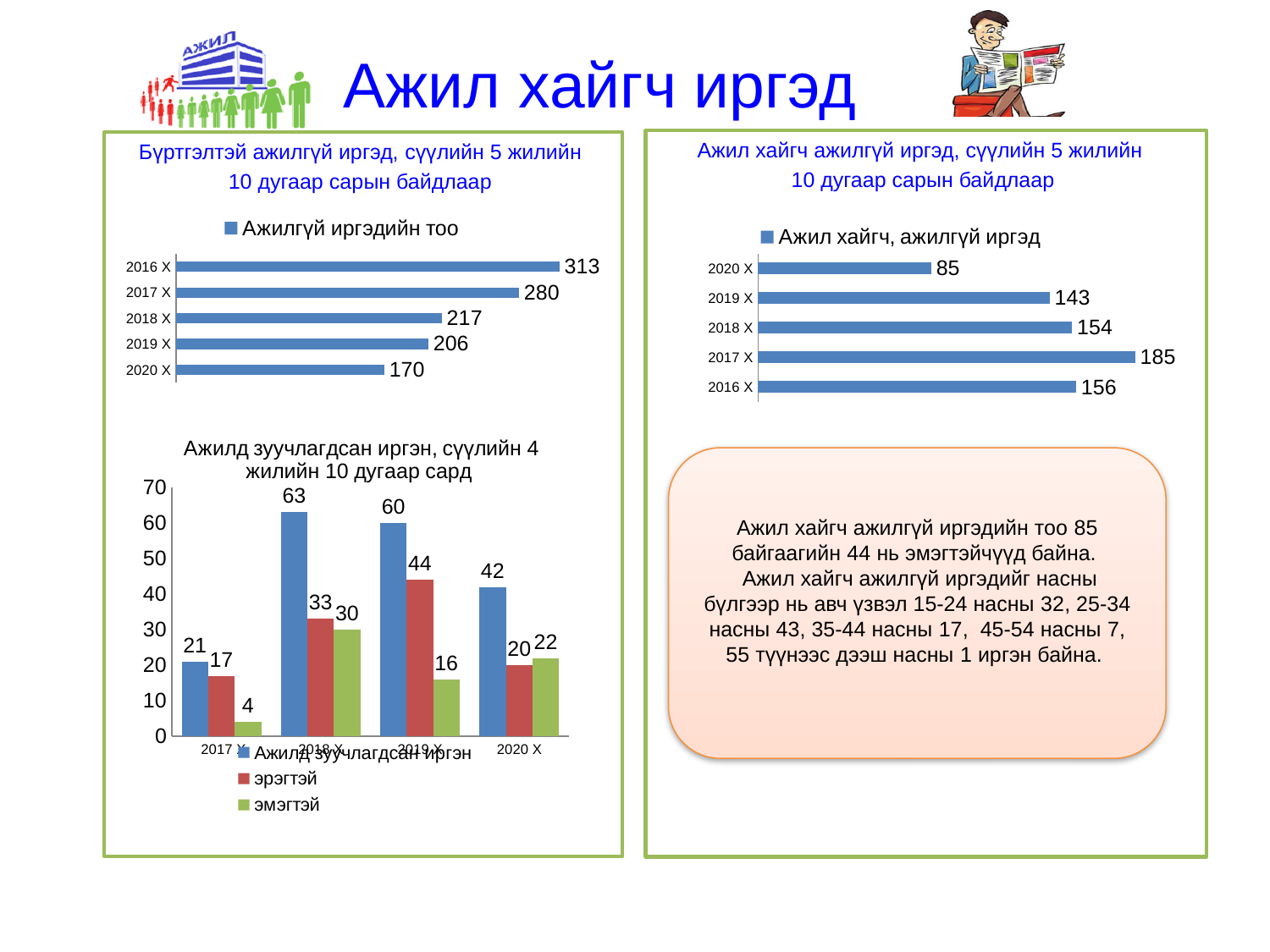
What kind of chart is the one titled 'Ажилд зуучлагдсан иргэн, сүүлийн 4 жилийн 10 дугаар сард'? bar chart In the chart titled 'Ажил хайгч ажилгүй иргэд, сүүлийн 5 жилийн 10 дугаар сарын байдлаар', which is larger, the value for 2016 X or 2018 X? 2016 X In the chart titled 'Бүртгэлтэй ажилгүй иргэд, сүүлийн 5 жилийн 10 дугаар сарын байдлаар', what is the value for 2018 X? 217 In the chart titled 'Ажилд зуучлагдсан иргэн, сүүлийн 4 жилийн 10 дугаар сард', what is the difference between 'эрэгтэй' and 'эмэгтэй' for 2017 X? 13 In the chart titled 'Ажил хайгч ажилгүй иргэд, сүүлийн 5 жилийн 10 дугаар сарын байдлаар', how many years are shown? 5 In the chart titled 'Бүртгэлтэй ажилгүй иргэд, сүүлийн 5 жилийн 10 дугаар сарын байдлаар', what is the difference between the values for 2016 X and 2020 X? 143 In the chart titled 'Ажил хайгч ажилгүй иргэд, сүүлийн 5 жилийн 10 дугаар сарын байдлаар', what is the value for 2019 X? 143 In the chart titled 'Ажил хайгч ажилгүй иргэд, сүүлийн 5 жилийн 10 дугаар сарын байдлаар', which year has the lowest value? 2020 X In the chart titled 'Бүртгэлтэй ажилгүй иргэд, сүүлийн 5 жилийн 10 дугаар сарын байдлаар', do the values rise or fall from 2016 X to 2020 X? fall In the chart titled 'Ажилд зуучлагдсан иргэн, сүүлийн 4 жилийн 10 дугаар сард', what is the value of 'эрэгтэй' for 2019 X? 44 In the chart titled 'Бүртгэлтэй ажилгүй иргэд, сүүлийн 5 жилийн 10 дугаар сарын байдлаар', which year has the highest value? 2016 X In the chart titled 'Ажилд зуучлагдсан иргэн, сүүлийн 4 жилийн 10 дугаар сард', how many series does the legend list? 3